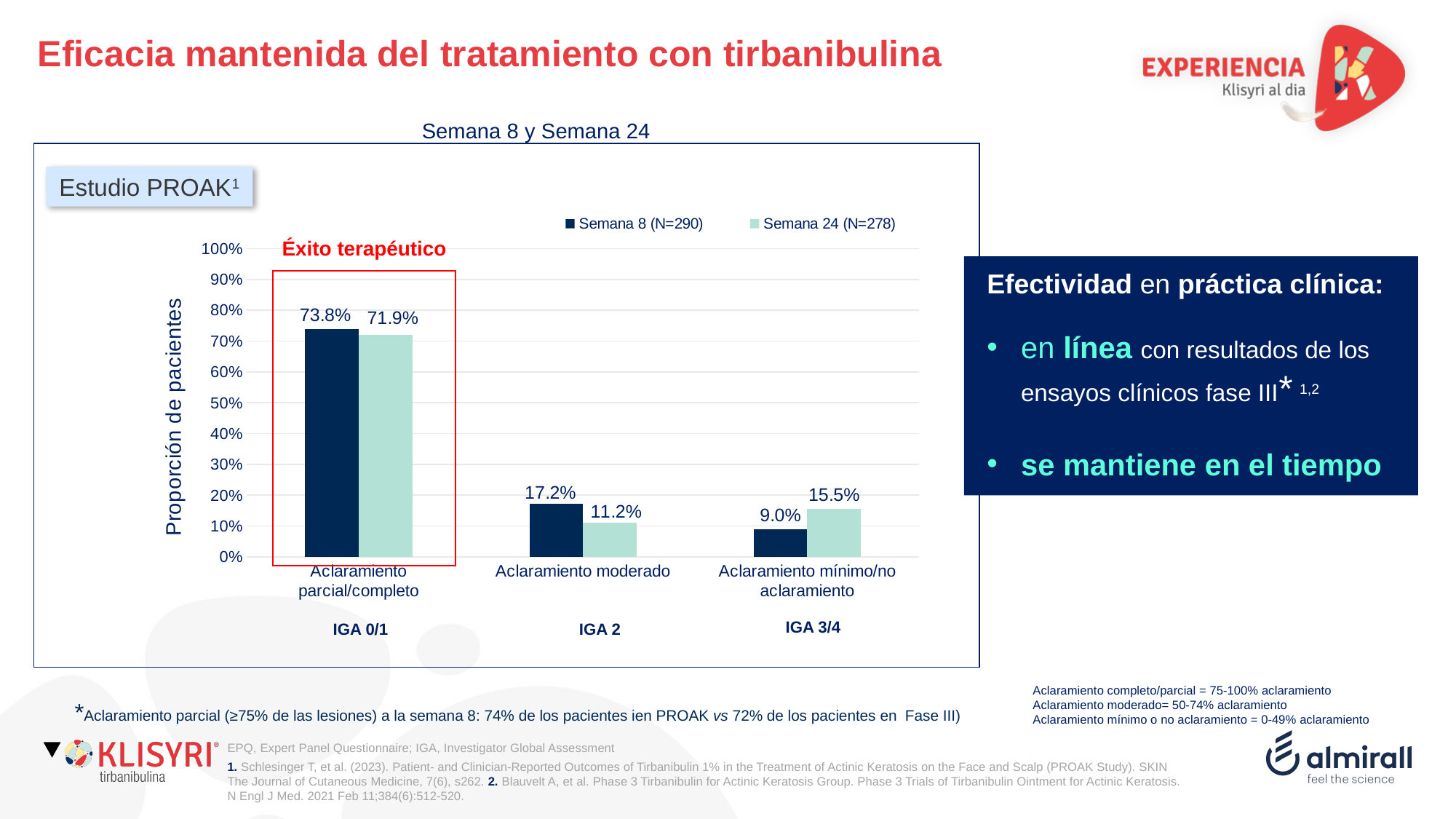
What is the difference between the Semana 8 and Semana 24 values for Aclaramiento moderado? 6.0% Is the Semana 24 value for Aclaramiento parcial/completo greater or less than 70%? greater What kind of chart is shown on the slide? Bar chart What is the value for Aclaramiento parcial/completo in the Semana 8 (N=290) series? 73.8% Which category has the highest value in the Semana 24 (N=278) series? Aclaramiento parcial/completo How many categories are shown on the x axis of the chart? 3 For Aclaramiento mínimo/no aclaramiento, which series has the larger value, Semana 8 or Semana 24? Semana 24 Which category has the lowest value in the Semana 8 (N=290) series? Aclaramiento mínimo/no aclaramiento What is the value for Aclaramiento mínimo/no aclaramiento in the Semana 8 (N=290) series? 9.0% How many series does the chart legend list? 2 What is the difference between the Semana 8 and Semana 24 values for Aclaramiento parcial/completo? 1.9% What is the value for Aclaramiento moderado in the Semana 24 (N=278) series? 11.2%